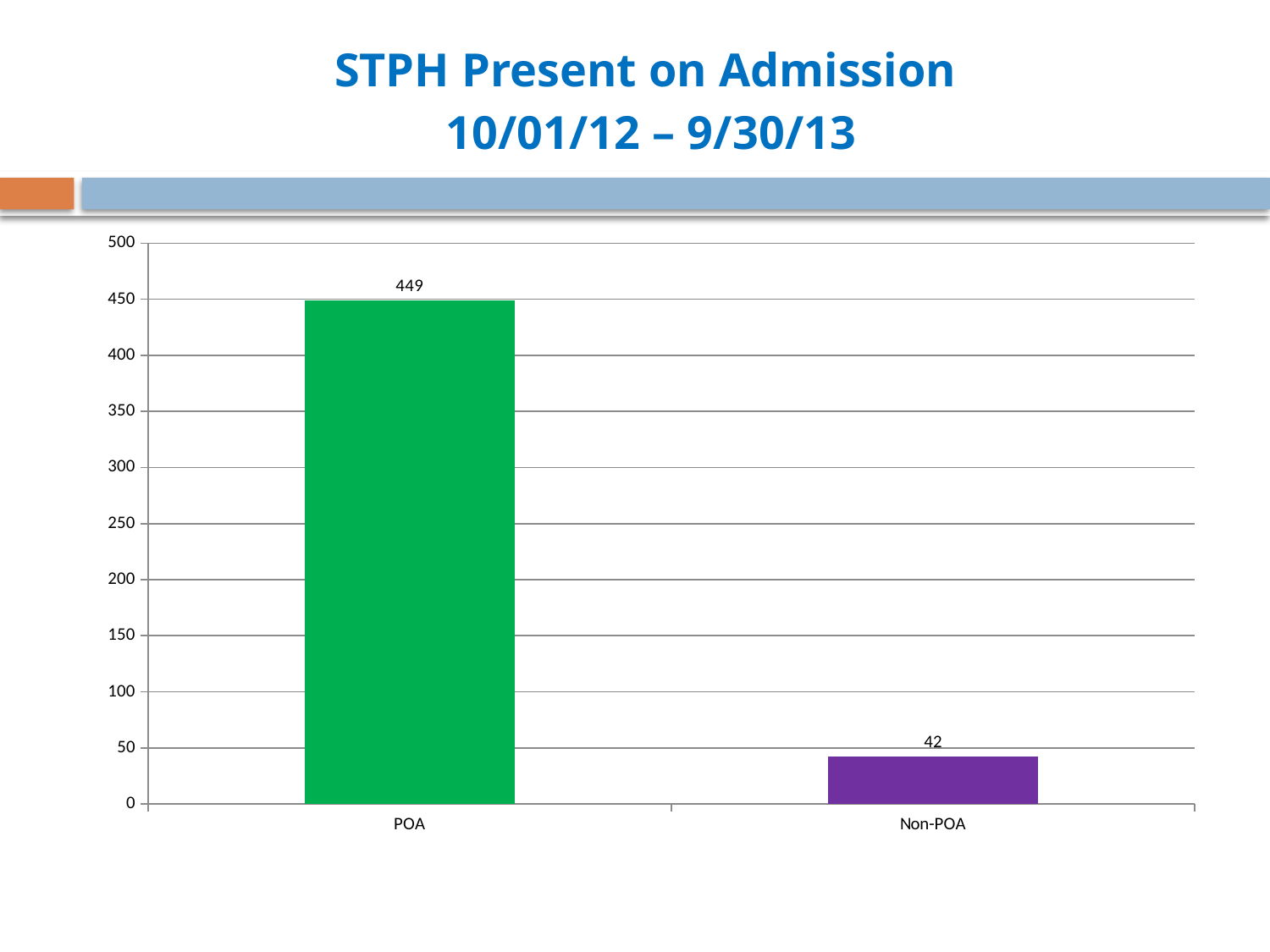
What is the value for POA? 449 Which is larger, the value for POA or the value for Non-POA? POA Which category has the highest value? POA What colour is the bar for Non-POA? purple Is the value for POA greater or less than 400? greater What is the value for Non-POA? 42 Which category has the lowest value? Non-POA Is the value for Non-POA greater or less than 50? less What is the title of the slide? STPH Present on Admission 10/01/12 – 9/30/13 How many categories are shown on the x axis? 2 What kind of chart is shown on the slide? bar chart What is the difference between the POA and Non-POA values? 407